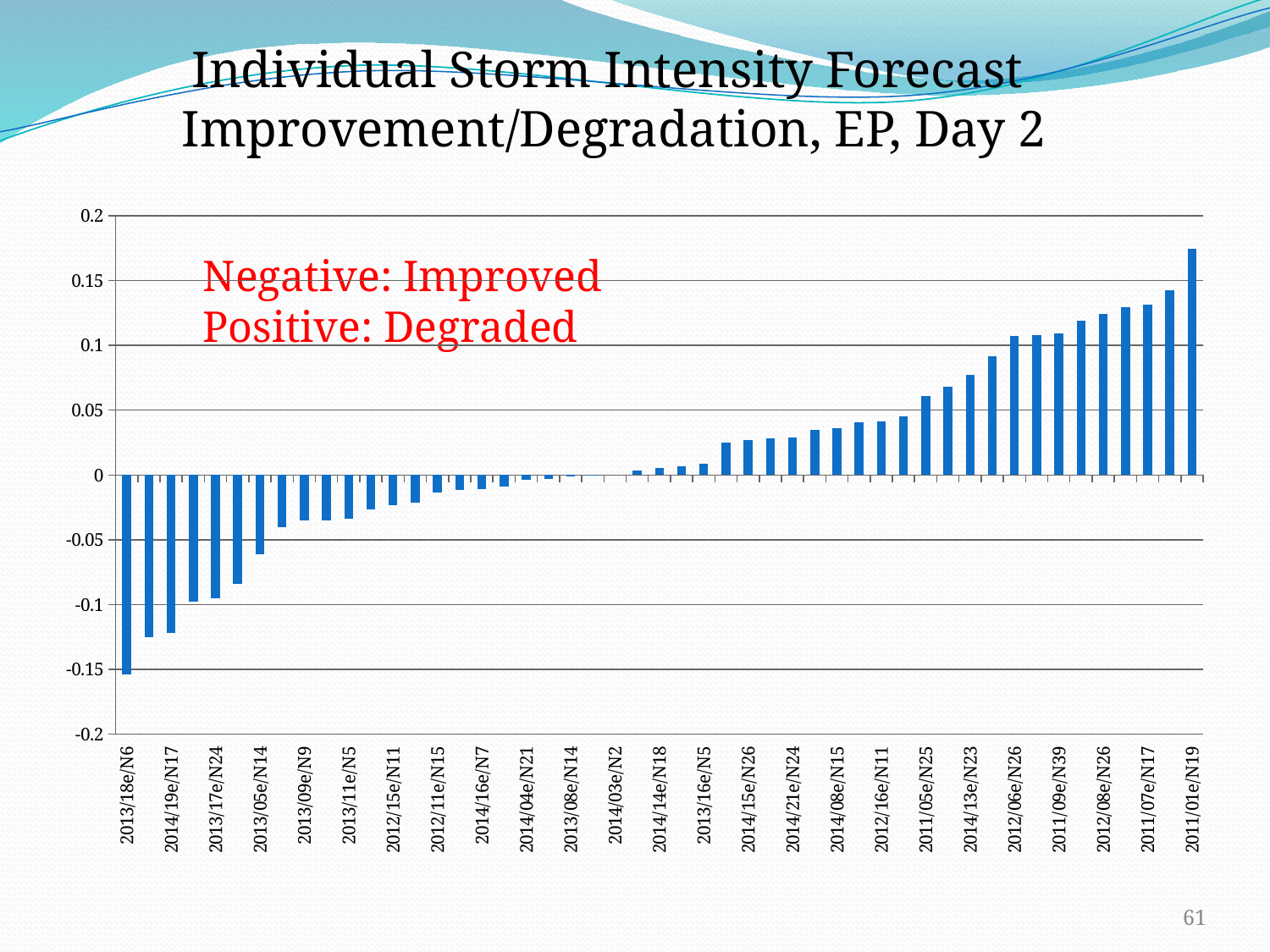
Is the value for 2014/19e/N17 greater or less than -0.1? less Is the value for 2011/07e/N17 greater or less than 0.1? greater Which category has the lowest value? 2013/18e/N6 Which category has the highest value? 2011/01e/N19 Is the value for 2014/15e/N26 greater or less than 0.05? less Do the bar values rise or fall from left to right along the x axis? rise According to the annotation on the chart, what does a negative value indicate? Improved What kind of chart is shown on the slide? bar chart Which has the larger value, 2013/18e/N6 or 2014/19e/N17? 2014/19e/N17